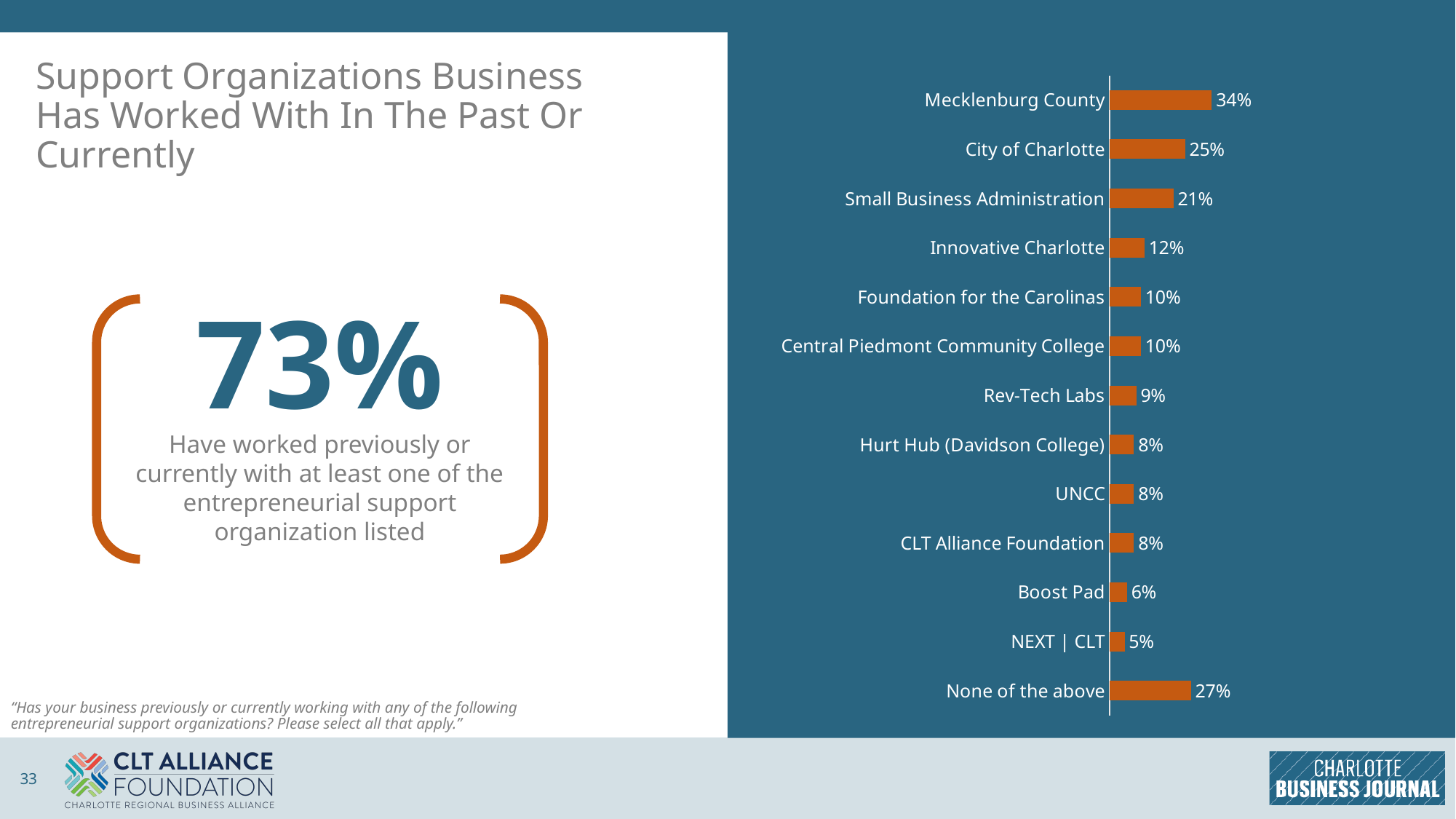
What percentage of businesses have worked with Mecklenburg County? 34% What percentage is shown for None of the above? 27% Which category has the lowest percentage in the chart? NEXT | CLT What is the difference between the values for City of Charlotte and Small Business Administration? 4% What type of chart is shown on the slide? Bar chart What is the value for NEXT | CLT? 5% Which organization has the highest percentage in the chart? Mecklenburg County How many categories are plotted in the bar chart? 13 What is the value shown for the Small Business Administration? 21% What is the difference between the values for Mecklenburg County and City of Charlotte? 9% What colour are the bars in the chart? Orange Which is larger, the value for Innovative Charlotte or the value for Boost Pad? Innovative Charlotte